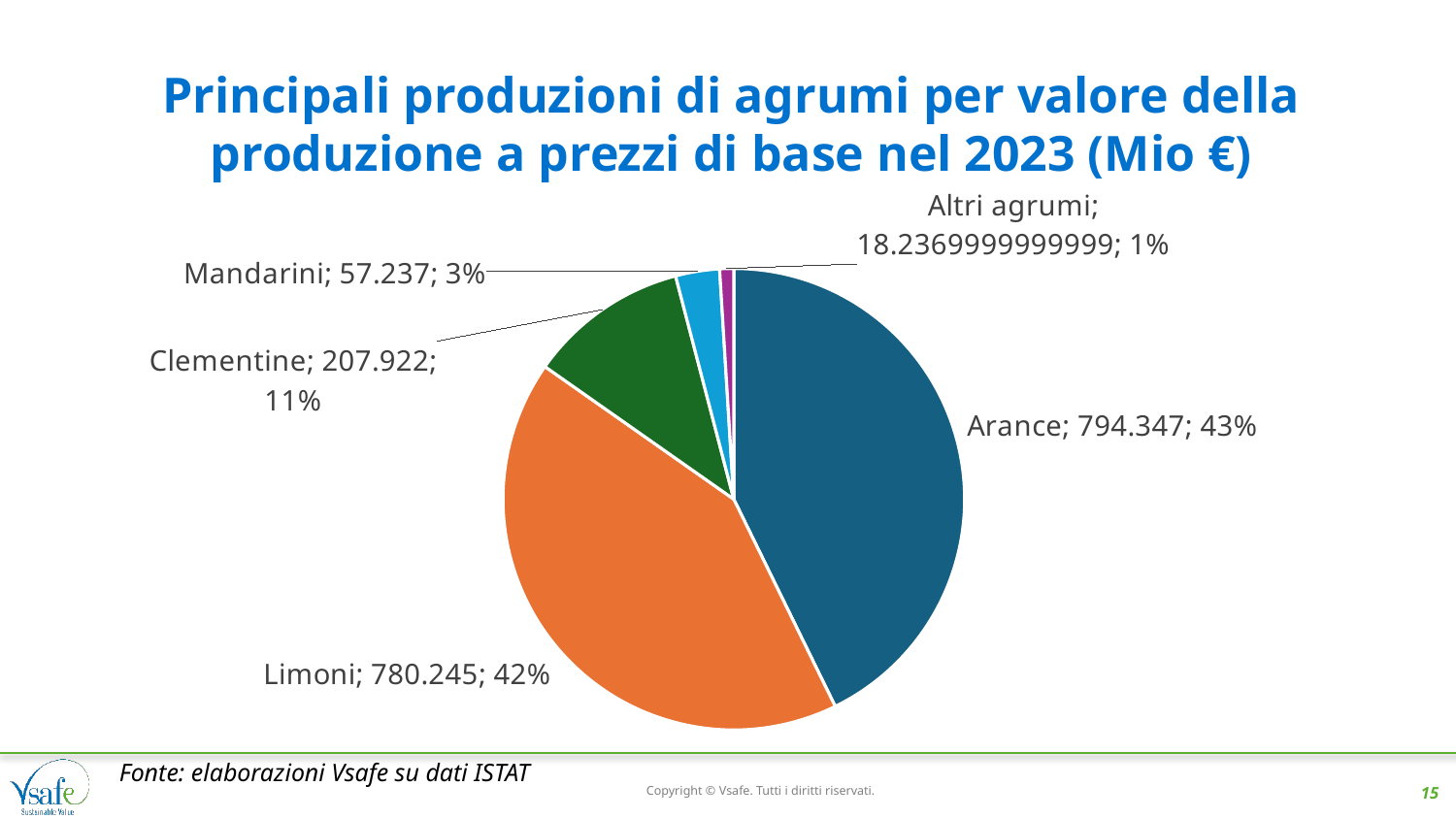
How many slices does the pie chart have? 5 What type of chart is shown on the slide? Pie chart What is the difference between the values for Clementine and Mandarini? 150.685 What is the value shown for Mandarini? 57.237 What is the title of the chart? Principali produzioni di agrumi per valore della produzione a prezzi di base nel 2023 (Mio €) What share of the pie does Clementine represent? 11% Which category has the largest slice of the pie? Arance What share of the pie does Limoni represent? 42% What is the value shown for Clementine? 207.922 What is the value shown for Limoni? 780.245 Which category has the smallest slice of the pie? Altri agrumi What is the value shown for Arance? 794.347